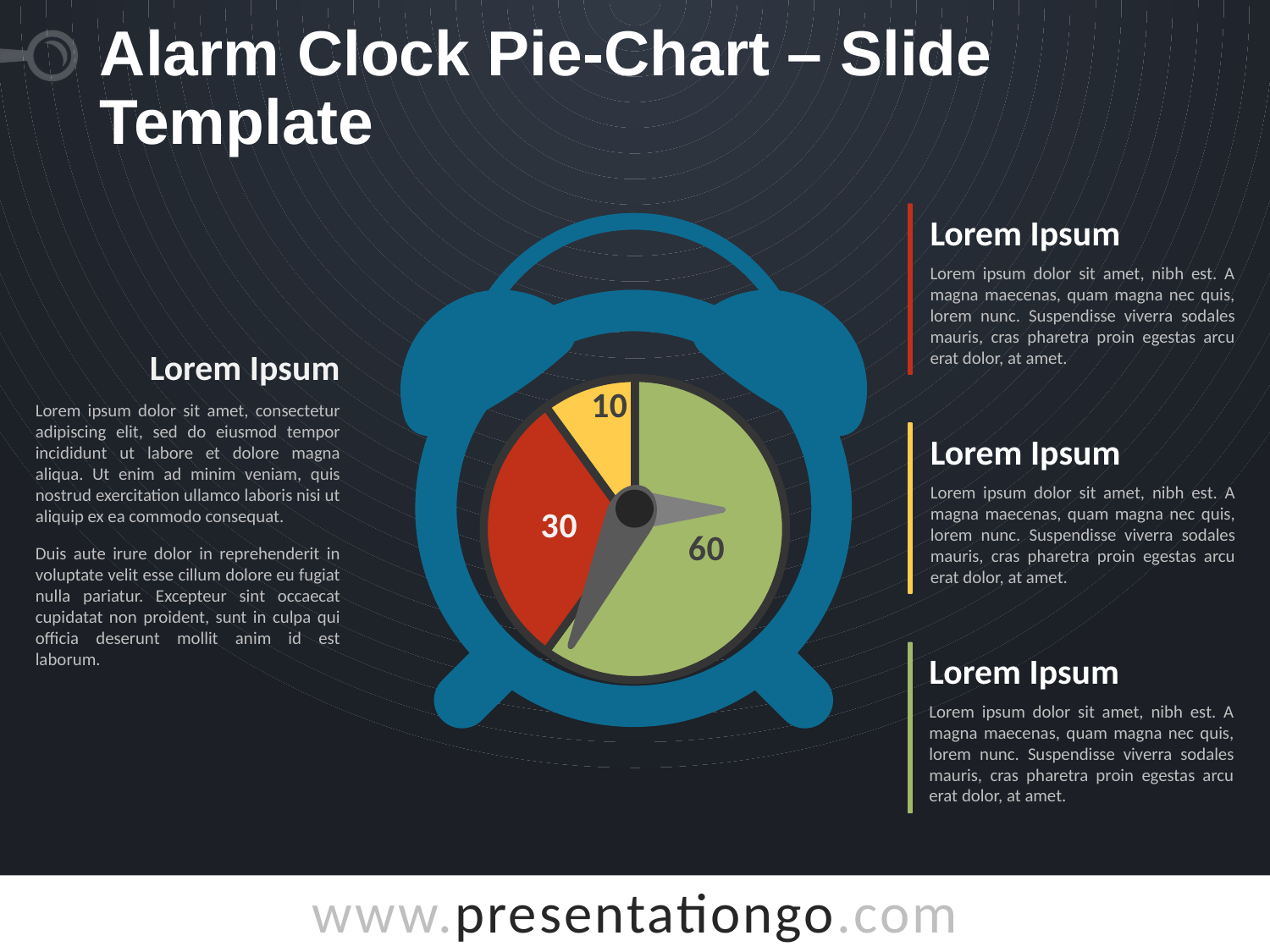
What kind of chart is shown inside the alarm clock? pie chart What is the value shown on the green slice of the pie chart? 60 Which slice of the pie chart has the smallest value? 10 Which slice of the pie chart has the largest value? 60 How many slices does the pie chart have? 3 What share of the pie does the slice labelled 30 represent? 30% What is the difference between the red slice value and the yellow slice value? 20 What is the total of all slice values in the pie chart? 100 What is the difference between the largest and smallest slice values in the pie chart? 50 Which is larger, the red slice or the yellow slice? red slice What is the value shown on the red slice of the pie chart? 30 What is the value shown on the yellow slice of the pie chart? 10